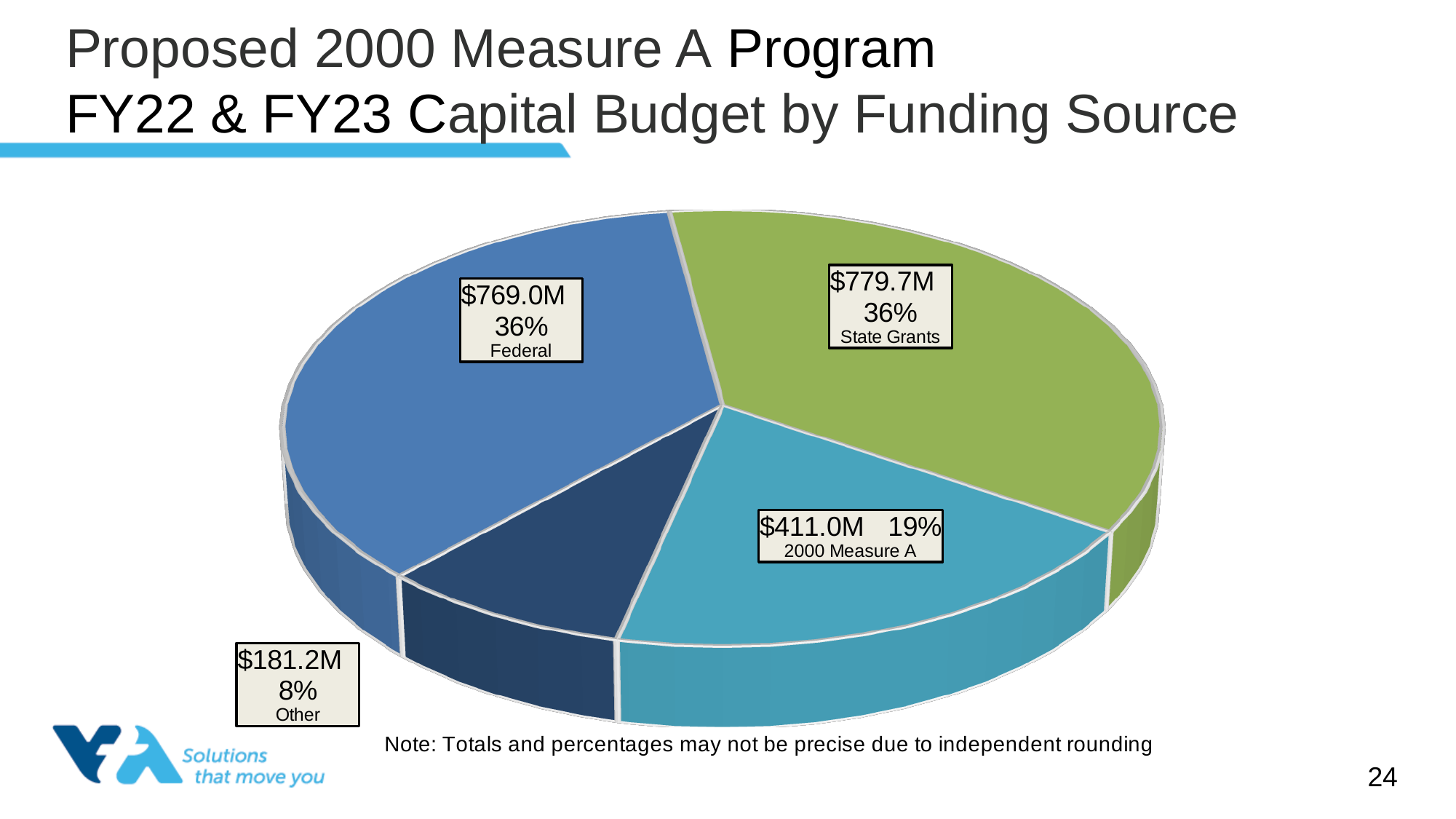
What kind of chart is shown on the slide? Pie chart Which is larger, the Federal amount or the 2000 Measure A amount? Federal How many slices does the pie chart have? 4 What is the difference in dollars between State Grants and Federal funding? $10.7M What does the note below the chart say totals and percentages may not be precise due to? Independent rounding Which funding source has the smallest dollar amount? Other What is the dollar amount for 2000 Measure A? $411.0M What percentage share of the pie does Other represent? 8% Which funding source has the largest dollar amount? State Grants What is the dollar amount for Federal funding? $769.0M What is the dollar amount for State Grants? $779.7M What percentage share of the pie does 2000 Measure A represent? 19%